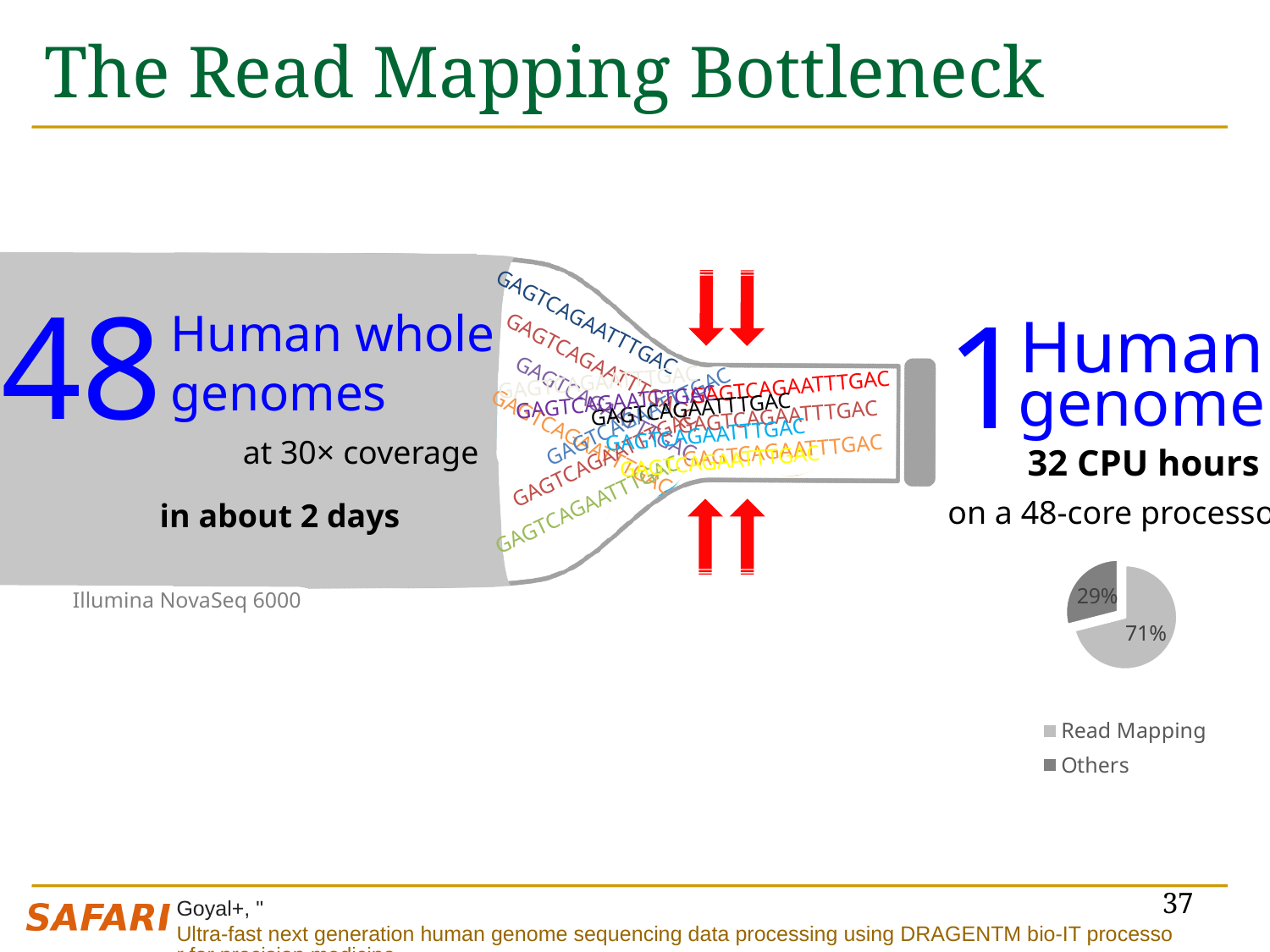
Which slice of the pie chart is the largest? Read Mapping What share of the pie chart does Others take? 29% Which is larger in the pie chart, Read Mapping or Others? Read Mapping What are the two legend entries of the pie chart? Read Mapping, Others What share of the pie chart does Read Mapping take? 71% Is the Read Mapping share of the pie chart greater or less than 50%? greater What is the difference in percentage points between the Read Mapping slice and the Others slice? 42 How many slices does the pie chart have? 2 Which slice of the pie chart is the smallest? Others Which legend entry of the pie chart is shown in the darker gray? Others What kind of chart is shown on the slide? pie chart How many entries does the pie chart's legend list? 2